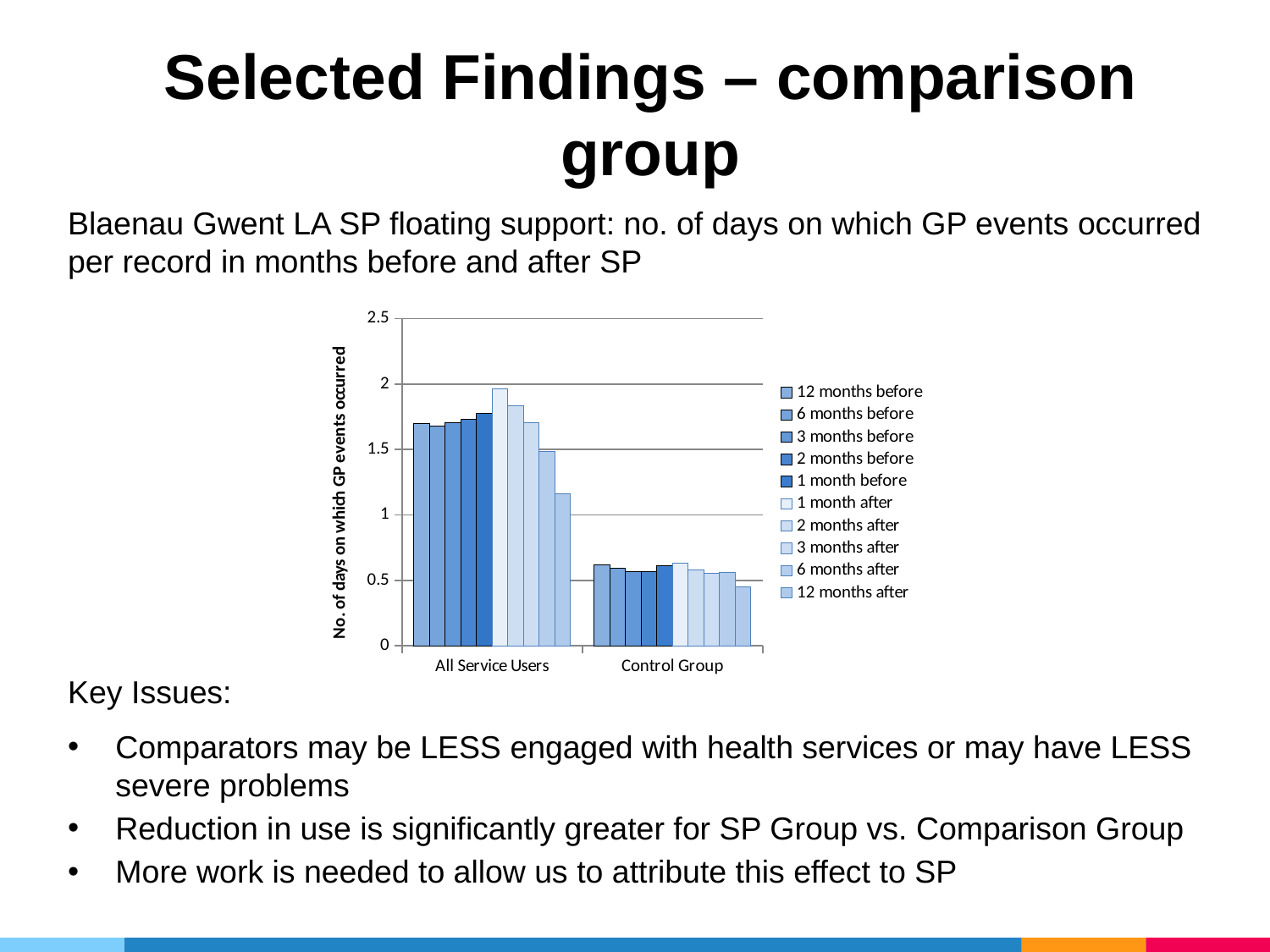
What kind of chart is shown on the slide? bar chart Is the value for Control Group 12 months after greater or less than 0.5? less How many categories are shown on the x axis? 2 Is the value for All Service Users 12 months before greater or less than 1.5? greater What is the label of the y axis? No. of days on which GP events occurred For All Service Users, do the values rise or fall from 1 month after to 12 months after? fall How many series does the legend list? 10 Which series has the highest value for All Service Users? 1 month after Is the value for All Service Users 12 months after greater or less than 1? greater Which is larger for 1 month after: All Service Users or Control Group? All Service Users Which series has the lowest value for All Service Users? 12 months after